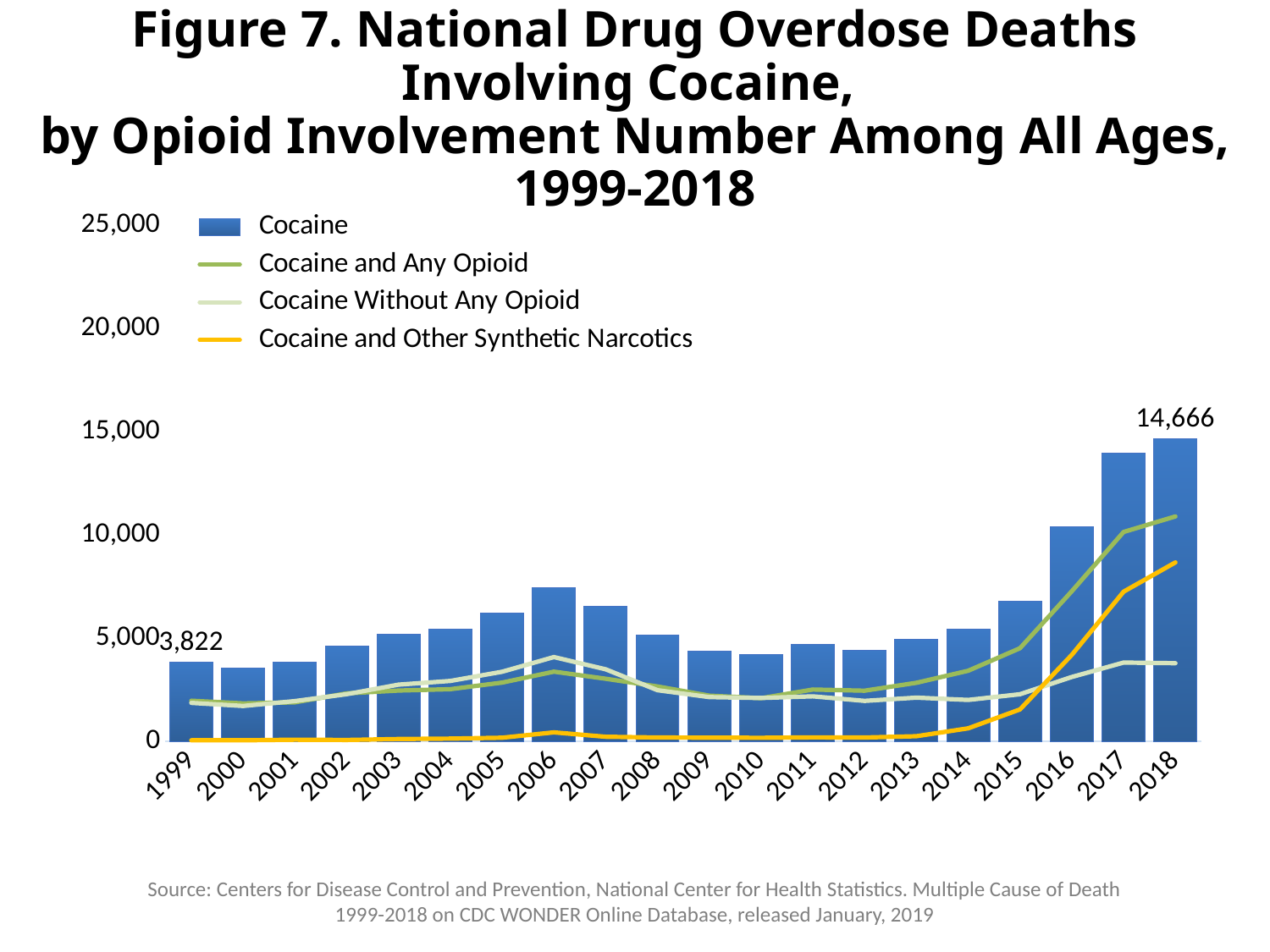
What is the value of the Cocaine bar for 2018? 14,666 Which year has the larger Cocaine bar, 2006 or 2010? 2006 How many series does the legend list? 4 How many years are shown on the x axis? 20 Which year has the highest Cocaine bar? 2018 Do the Cocaine bars rise or fall from 2013 to 2018? rise What is the value of the Cocaine bar for 1999? 3,822 Is the Cocaine bar for 2006 greater or less than 5,000? greater Is the Cocaine Without Any Opioid value for 2018 greater or less than 5,000? less What is the difference between the Cocaine values for 2018 and 1999? 10,844 Is the Cocaine bar for 2017 greater or less than 10,000? greater